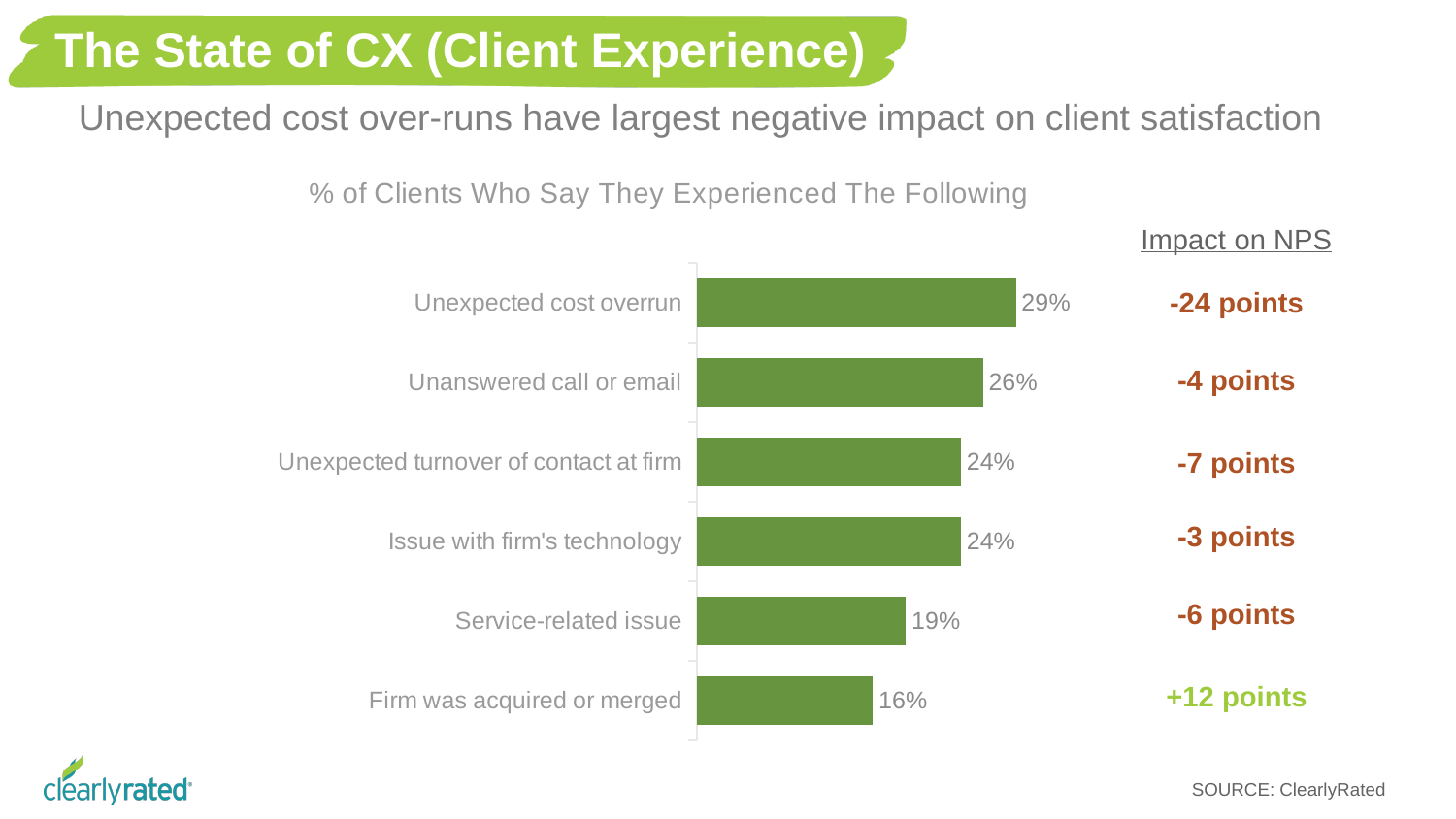
What is the impact on NPS listed for 'Unexpected cost overrun'? -24 points Which category has the lowest percentage of clients who experienced it? Firm was acquired or merged Which category is the only one with a positive impact on NPS? Firm was acquired or merged What percentage of clients say they experienced a service-related issue? 19% What percentage of clients say their firm was acquired or merged? 16% Which category has the highest percentage of clients who experienced it? Unexpected cost overrun What percentage of clients say they experienced an unexpected cost overrun? 29% How many categories are shown in the bar chart? 6 What is the title of the chart? % of Clients Who Say They Experienced The Following What is the difference in percentage points between 'Unexpected cost overrun' and 'Unanswered call or email'? 3 percentage points Which is larger: the percentage for 'Unanswered call or email' or for 'Service-related issue'? Unanswered call or email What kind of chart is shown on the slide? Bar chart